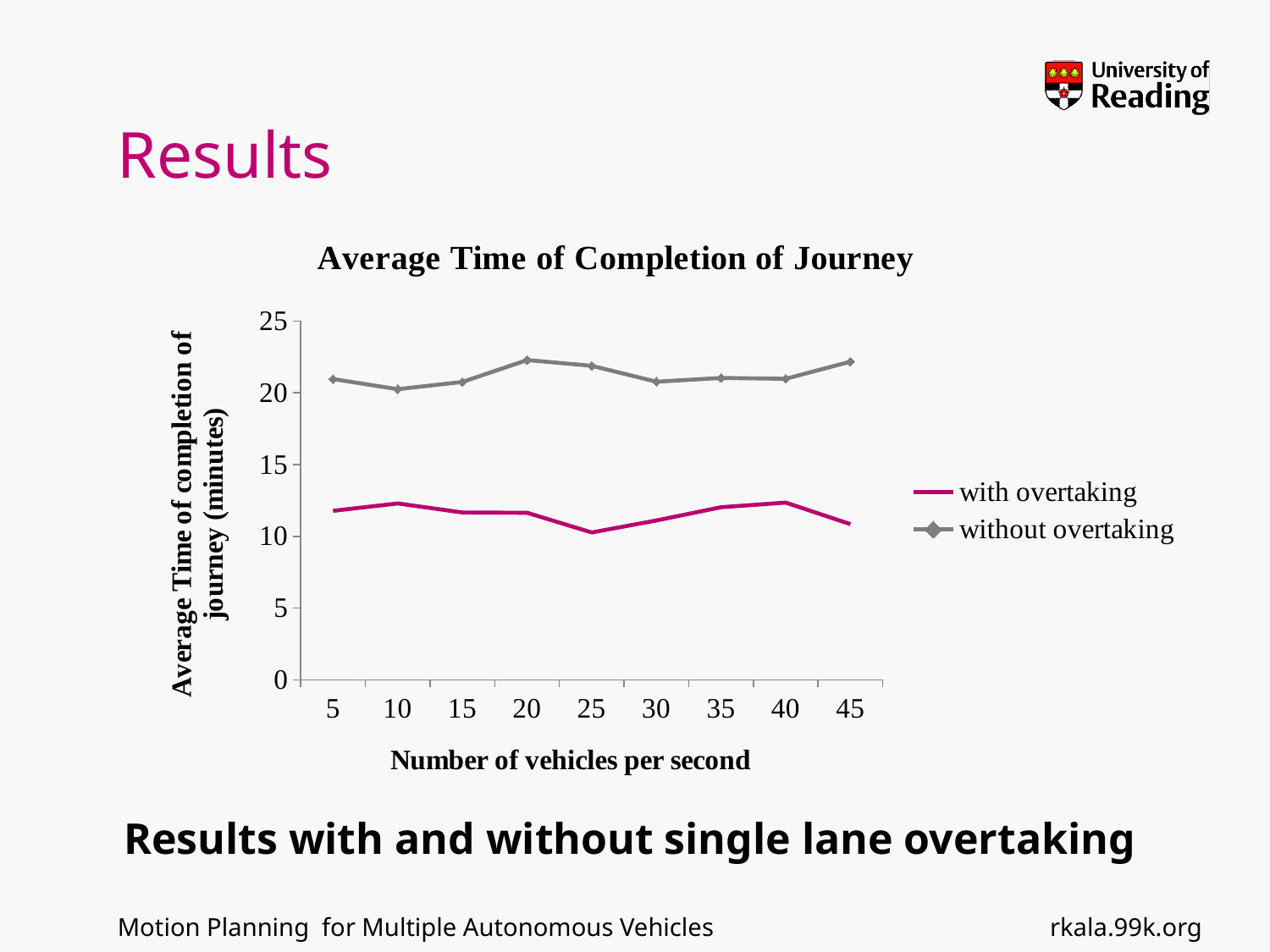
Is the value for 'with overtaking' at 40 vehicles per second greater or less than 15? less Is the value for 'with overtaking' at 5 vehicles per second greater or less than 10? greater What is the label of the x axis? Number of vehicles per second What is the title of the chart? Average Time of Completion of Journey How many series does the legend list? 2 Which series is plotted consistently above the other across all x-axis values? without overtaking How many x-axis points (values of number of vehicles per second) are plotted? 9 What kind of chart is shown on the slide? line chart Is the value for 'without overtaking' at 20 vehicles per second greater or less than 20? greater At 25 vehicles per second, which series has the higher value, 'with overtaking' or 'without overtaking'? without overtaking